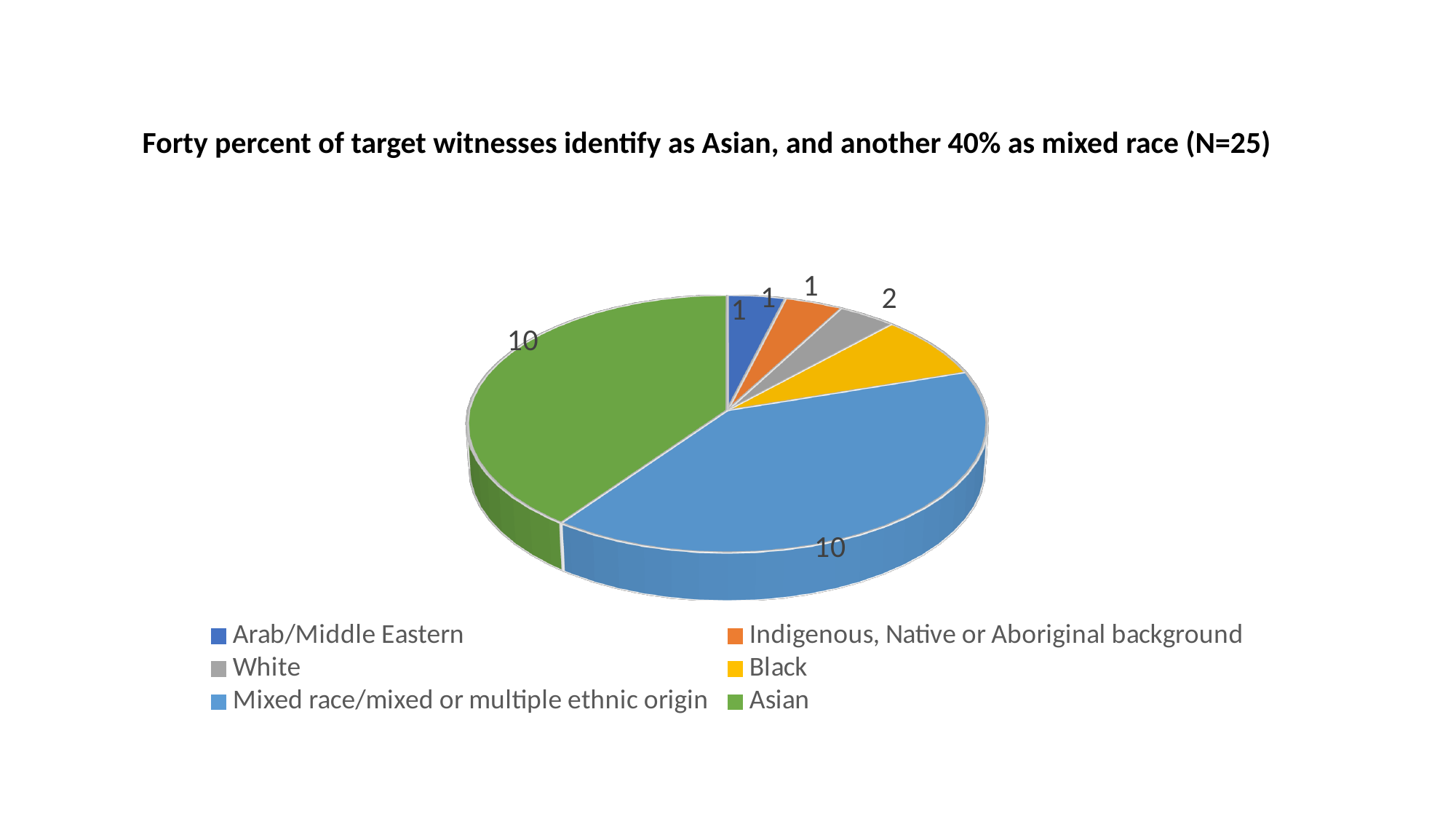
Which is larger, the value for Black or the value for White? Black What is the value for Arab/Middle Eastern? 1 What colour is the Asian slice in the pie chart? Green How many categories does the pie chart show? 6 What share of the pie does the Asian slice represent? 40% What is the value for White in the pie chart? 1 What is the value for Asian in the pie chart? 10 What share of the pie does the Black slice represent? 8% What is the difference between the value for Asian and the value for Black? 8 What is the value for Mixed race/mixed or multiple ethnic origin? 10 What is the value for Black in the pie chart? 2 What kind of chart is shown on the slide? Pie chart